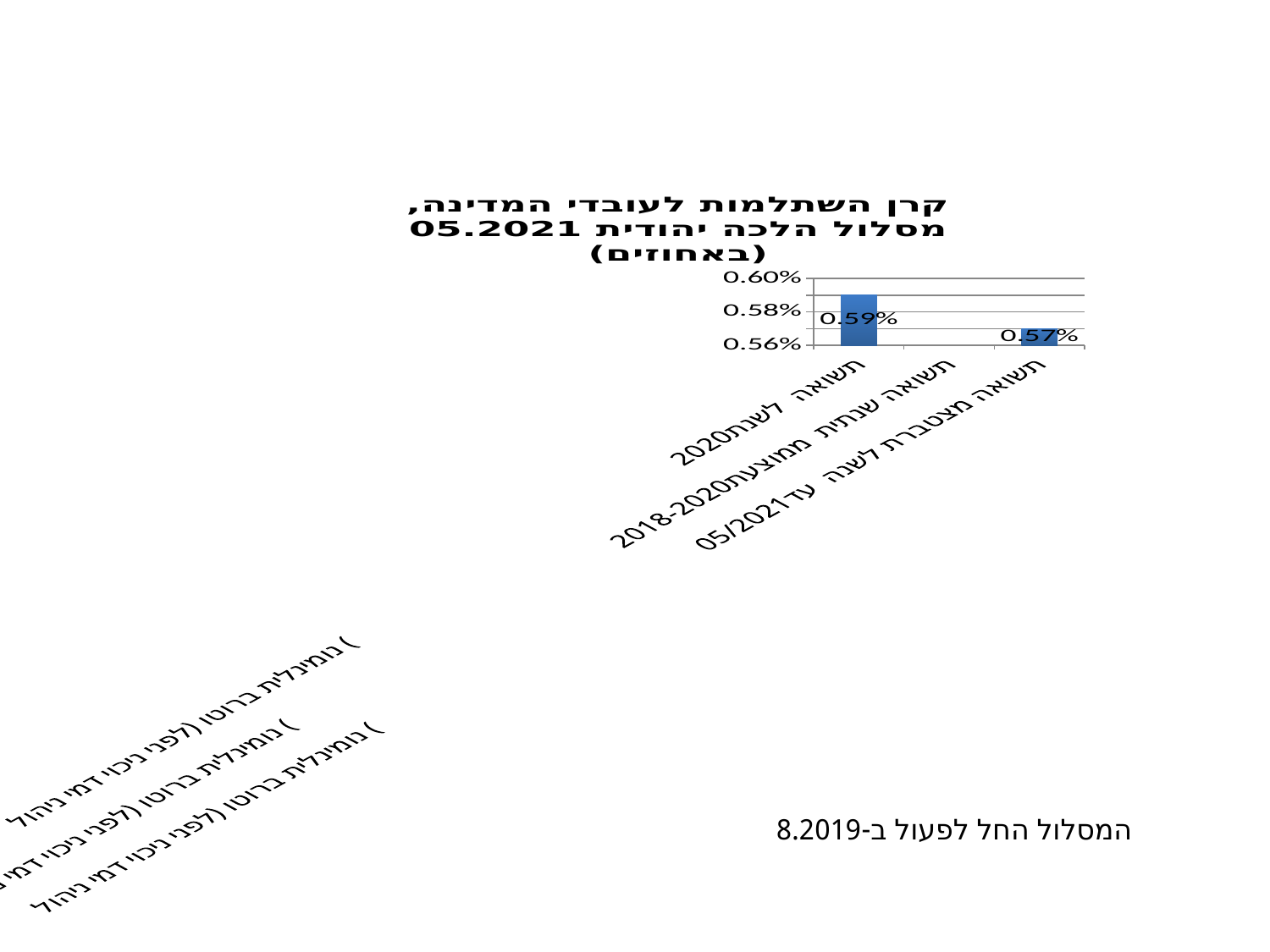
Is the value for תשואה מצטברת לשנה עד 05/2021 greater or less than 0.58%? less Is the value for תשואה לשנת 2020 greater or less than 0.58%? greater What is the value for תשואה מצטברת לשנה עד 05/2021? 0.57% What is the difference between the value for תשואה לשנת 2020 and the value for תשואה מצטברת לשנה עד 05/2021? 0.02% What is the value for תשואה לשנת 2020? 0.59% What kind of chart is shown on the slide? bar chart Which category on the x axis has no bar plotted? תשואה שנתית ממוצעת 2018-2020 Which category has the highest plotted value? תשואה לשנת 2020 Which is larger: the value for תשואה לשנת 2020 or the value for תשואה מצטברת לשנה עד 05/2021? תשואה לשנת 2020 What is the title of the chart? קרן השתלמות לעובדי המדינה, מסלול הלכה יהודית 05.2021 (באחוזים) How many categories are shown on the x axis of the chart? 3